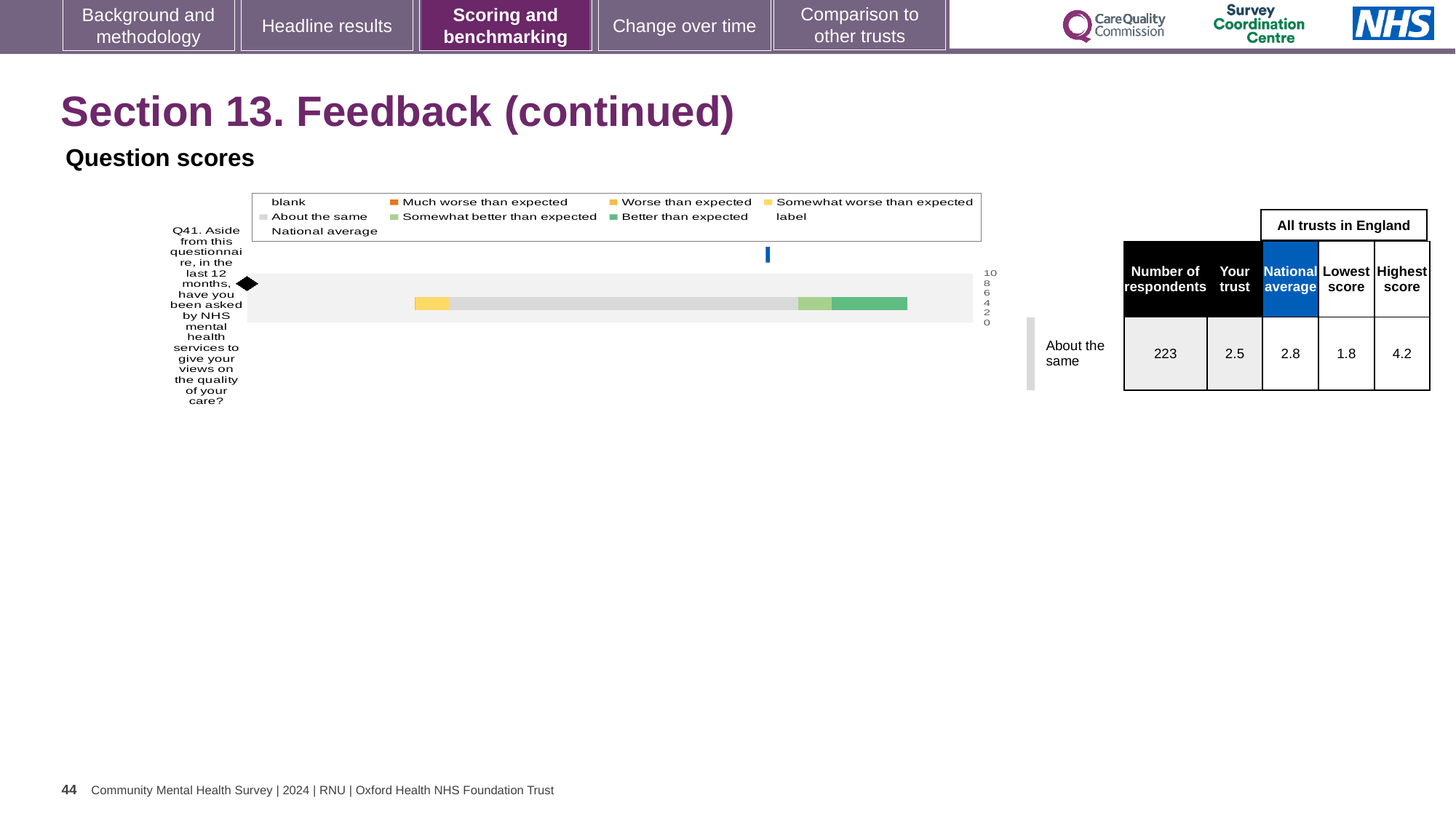
What is the national average score for Q41? 2.8 How many respondents answered Q41? 223 According to the legend, what colour represents 'Better than expected'? green What is the 'Your trust' score for Q41? 2.5 How many questions (categories) are plotted in the chart? 1 What is the highest score among all trusts in England for Q41? 4.2 What kind of chart is shown for Q41 on the slide? bar chart According to the legend, what colour represents 'About the same'? grey What is the lowest score among all trusts in England for Q41? 1.8 What is the difference between the highest score and the lowest score for Q41? 2.4 Which is larger for Q41, the 'Your trust' score or the national average? National average Which benchmark category is Q41 placed in? About the same